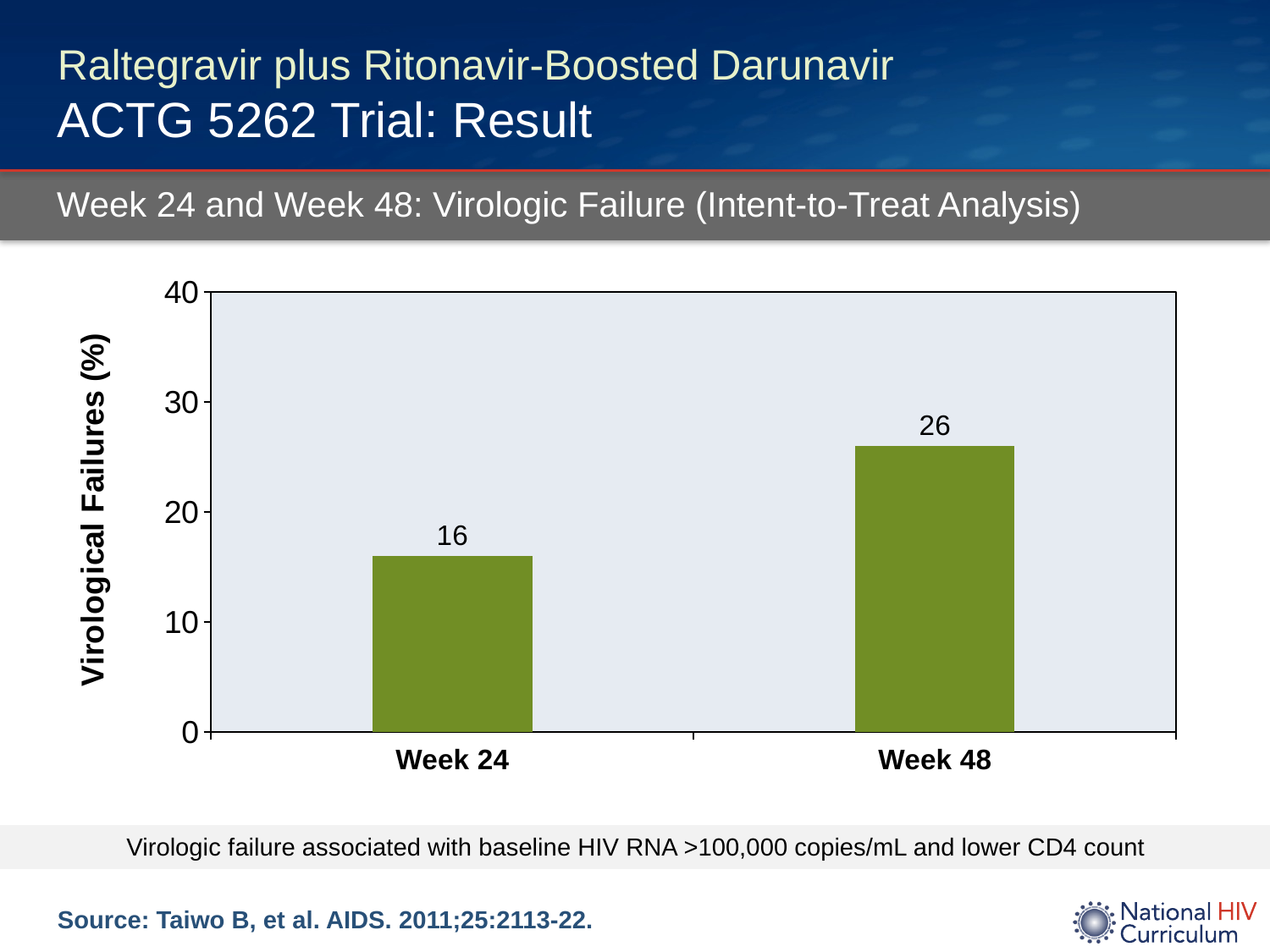
Which time point has the higher virological failure percentage? Week 48 What is the virological failure percentage at Week 24? 16 Is the value for Week 24 greater or less than 20? less What is the maximum value shown on the y axis? 40 Which time point has the lower virological failure percentage? Week 24 How many categories are shown on the x axis? 2 Do the values rise or fall from Week 24 to Week 48? Rise What kind of chart is shown on the slide? Bar chart What is the label of the y axis? Virological Failures (%) Is the value for Week 48 greater or less than 30? less What is the difference in virological failures between Week 48 and Week 24? 10 What is the virological failure percentage at Week 48? 26